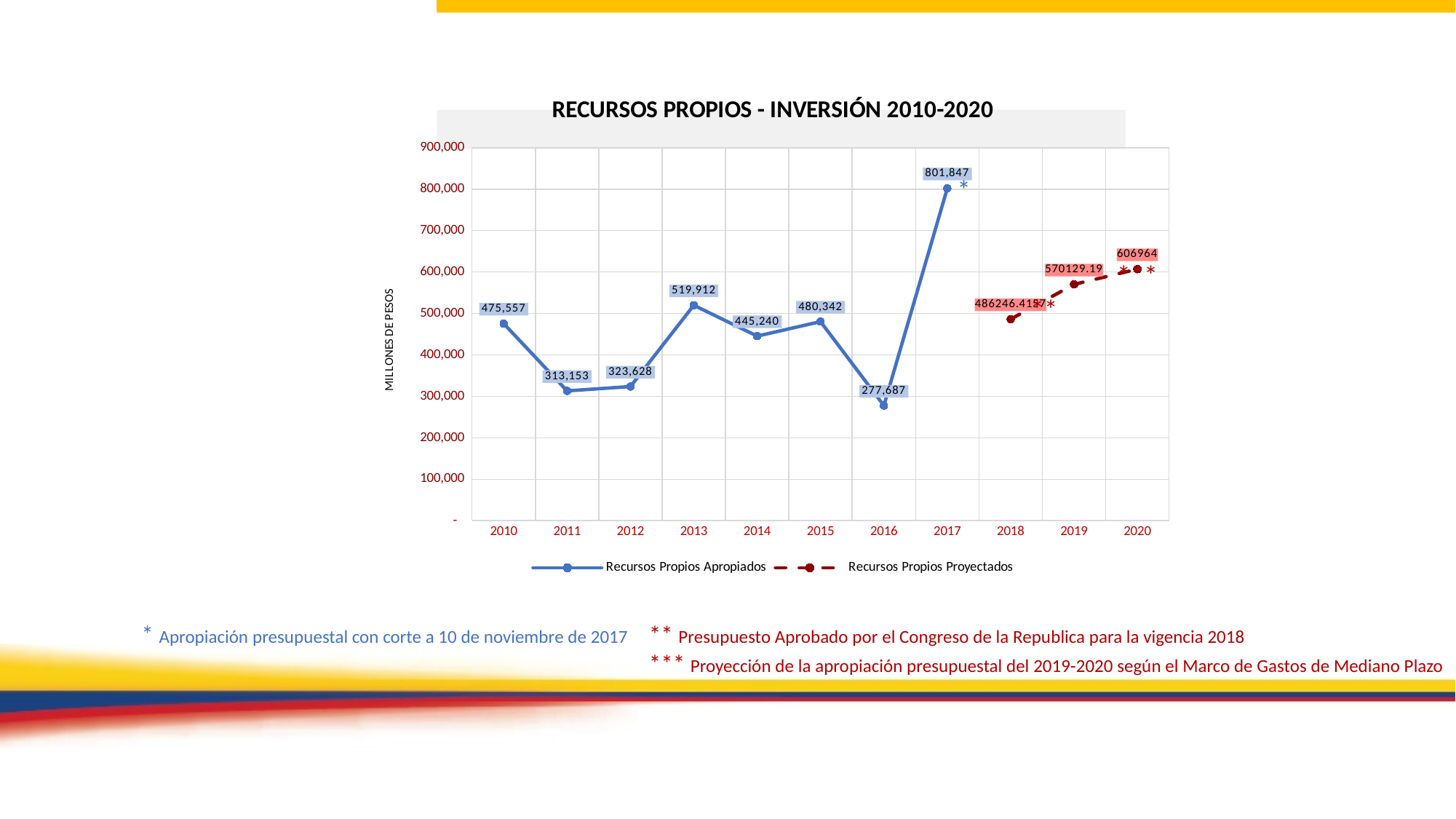
Do the Recursos Propios Proyectados values rise or fall from 2018 to 2020? rise What is the value for Recursos Propios Apropiados in 2017? 801,847 What is the value for Recursos Propios Proyectados in 2020? 606964 How many years are shown on the x axis? 11 What kind of chart is shown on the slide? line chart In which year is the Recursos Propios Apropiados value lowest? 2016 In which year is the Recursos Propios Apropiados value highest? 2017 What is the difference between the 2017 and 2016 values of Recursos Propios Apropiados? 524,160 Is the value for Recursos Propios Proyectados in 2018 greater or less than 500,000? less How many series does the legend list? 2 What is the value for Recursos Propios Apropiados in 2013? 519,912 Which year has the larger Recursos Propios Apropiados value, 2011 or 2012? 2012